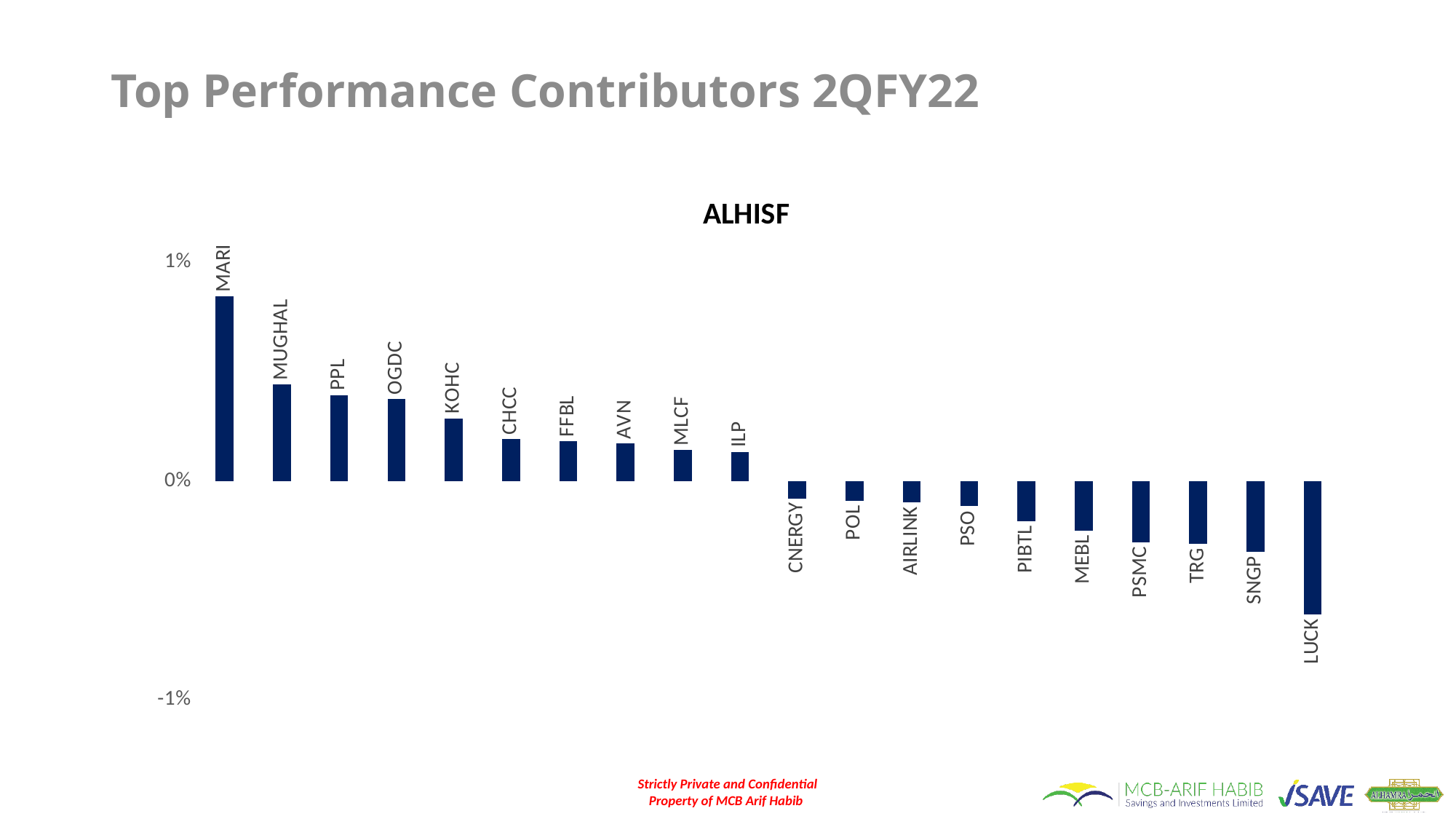
How many categories (bars) are plotted in the chart? 20 Do the values rise or fall moving from left to right along the x axis? fall Is the value for MARI greater or less than 1%? less What kind of chart is shown on the slide? bar chart Which category has the lowest value in the chart? LUCK Which has the larger value, SNGP or LUCK? SNGP Is the value for KOHC greater or less than 0%? greater What is the title of the chart? ALHISF How many bars in the chart have negative values? 10 Which category has the highest value in the chart? MARI Which has the larger value, MARI or MUGHAL? MARI Is the value for LUCK greater or less than 0%? less